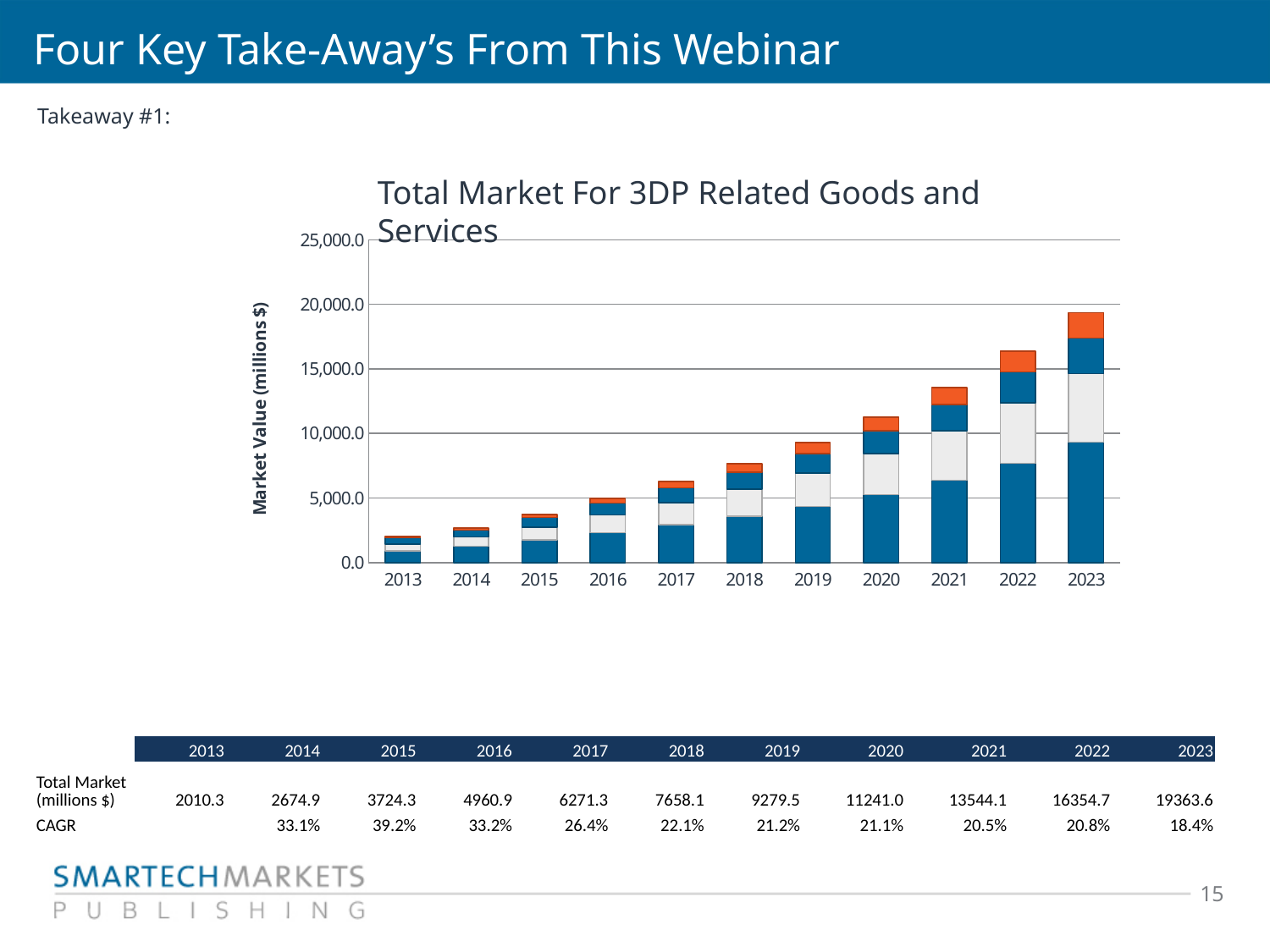
Is the total bar height for 2023 greater or less than 20,000.0? less According to the table, what is the CAGR for 2015? 39.2% What kind of chart is shown on the slide? bar chart Which year has the larger total market value, 2021 or 2022? 2022 Do the total market values rise or fall from 2013 to 2023? rise Which year has the tallest bar in the chart? 2023 What is the label on the vertical axis of the chart? Market Value (millions $) How many years are plotted along the x axis of the chart? 11 Which year has the shortest bar in the chart? 2013 According to the table, what is the Total Market (millions $) for 2018? 7658.1 Is the total bar height for 2020 greater or less than 10,000.0? greater Using the table values, what is the difference in Total Market (millions $) between 2023 and 2013? 17353.3